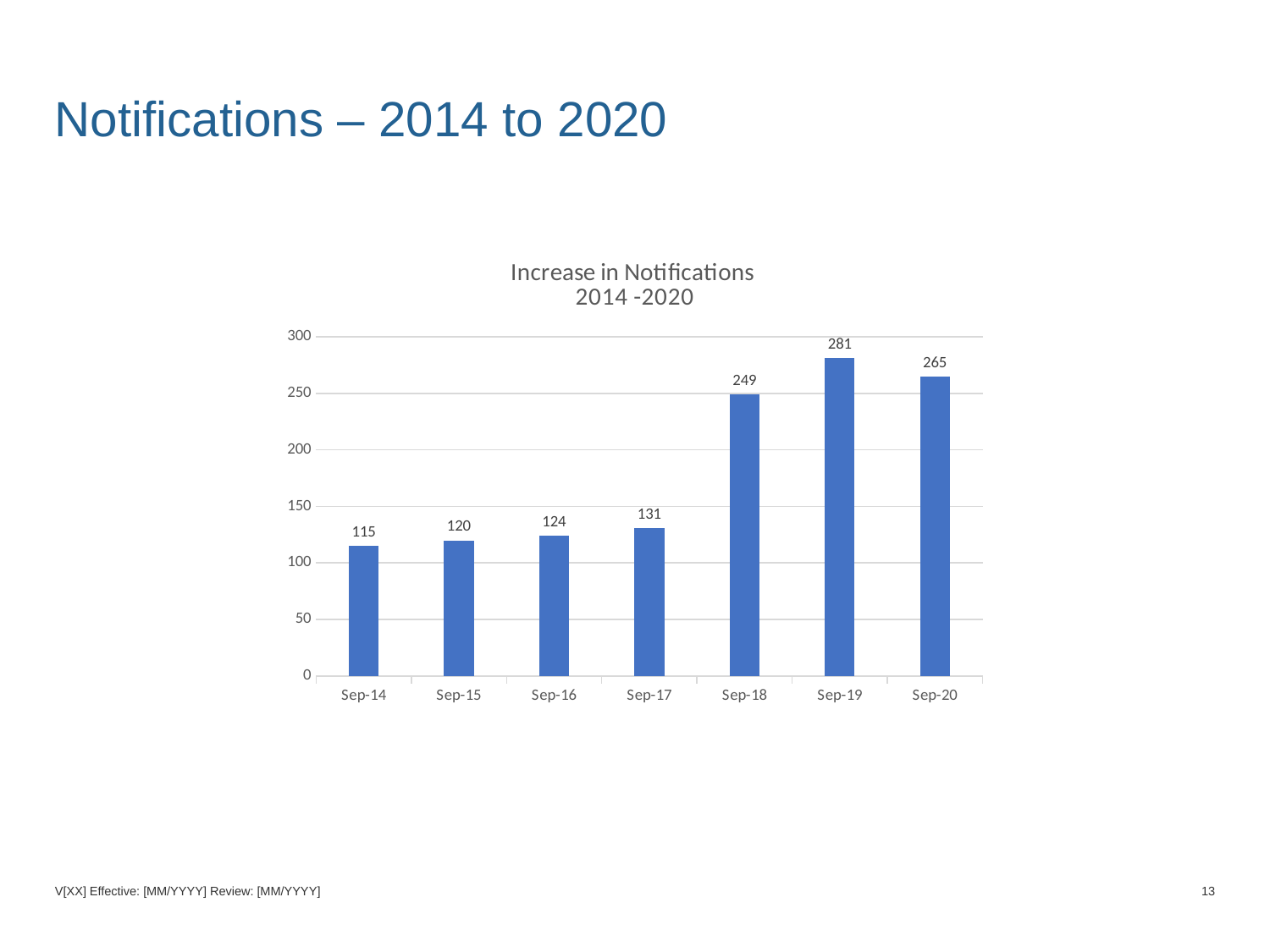
What is the difference between the values for Sep-18 and Sep-17? 118 Is the value for Sep-19 greater or less than 250? greater What is the difference between the values for Sep-19 and Sep-20? 16 Which category has the lowest value? Sep-14 What is the title of the chart? Increase in Notifications 2014 -2020 How many categories are shown on the x axis? 7 Which category has the highest value? Sep-19 What is the value for Sep-18? 249 Which is larger, the value for Sep-16 or the value for Sep-17? Sep-17 What kind of chart is shown on the slide? bar chart What is the value for Sep-20? 265 What is the value for Sep-14? 115